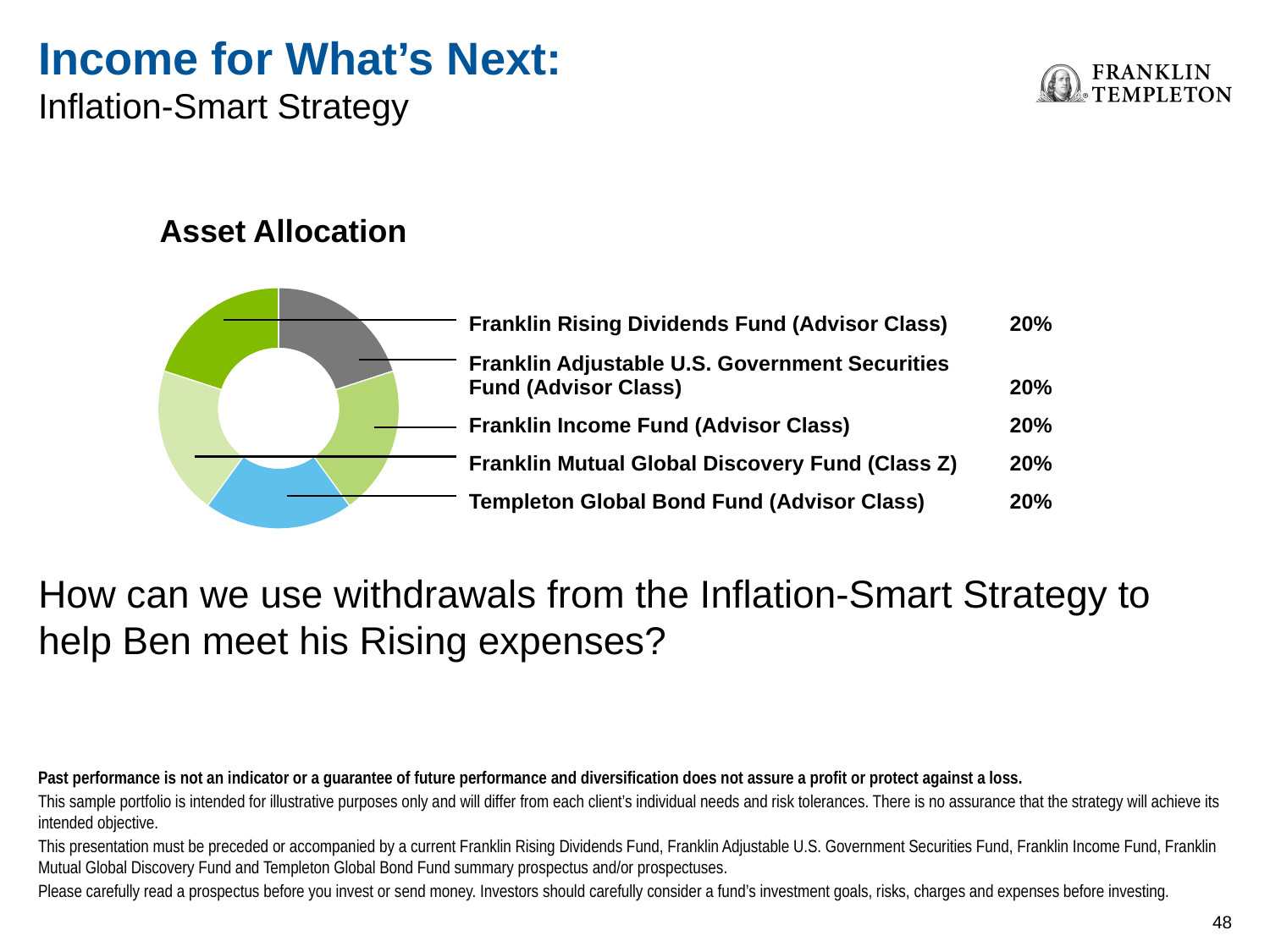
What share of the portfolio is the Templeton Global Bond Fund (Advisor Class)? 20% How many funds are shown in the Asset Allocation chart? 5 What is the combined allocation of the Franklin Rising Dividends Fund (Advisor Class) and the Franklin Mutual Global Discovery Fund (Class Z)? 40% What percentage of the Asset Allocation is the Franklin Mutual Global Discovery Fund (Class Z)? 20% What is the difference between the allocation to the Franklin Income Fund (Advisor Class) and the Templeton Global Bond Fund (Advisor Class)? 0% What percentage is allocated to the Franklin Adjustable U.S. Government Securities Fund (Advisor Class)? 20% What kind of chart is shown under the "Asset Allocation" heading? Doughnut chart What is the title of the chart on the slide? Asset Allocation What share of the Asset Allocation is the Franklin Rising Dividends Fund (Advisor Class)? 20% Do all five funds in the Asset Allocation chart have the same allocation? Yes What is the allocation to the Franklin Income Fund (Advisor Class)? 20% Which fund is listed last in the Asset Allocation chart's labels? Templeton Global Bond Fund (Advisor Class)